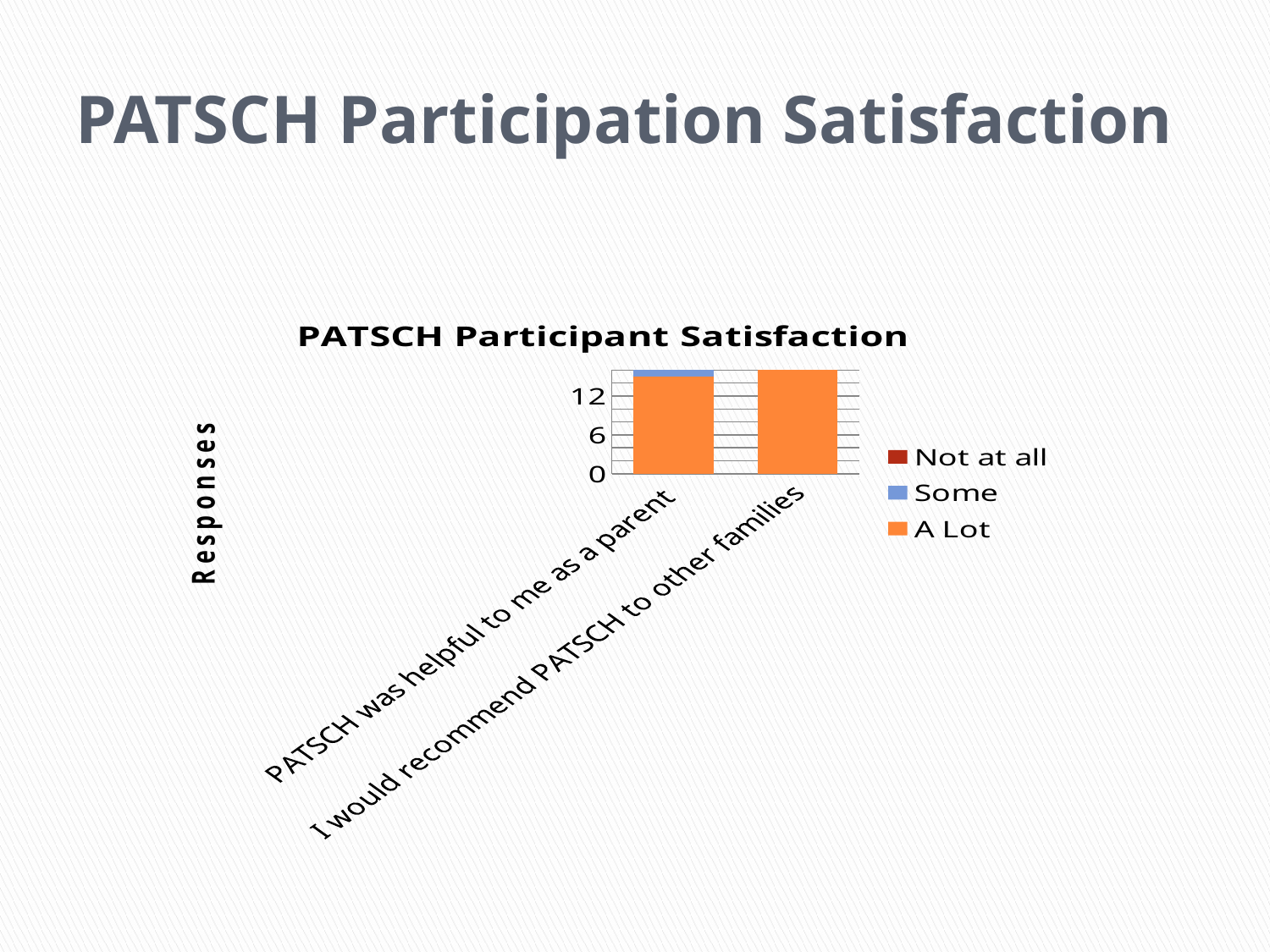
What is the title of the chart? PATSCH Participant Satisfaction Which category has the larger 'A Lot' value? I would recommend PATSCH to other families How many categories are shown on the x axis of the chart? 2 Is the 'Some' value for 'PATSCH was helpful to me as a parent' greater or less than 6? less Is the 'A Lot' value for 'PATSCH was helpful to me as a parent' greater or less than 12? greater What kind of chart is shown on the slide? bar chart Is the 'A Lot' value for 'I would recommend PATSCH to other families' greater or less than 12? greater Which category's bar includes a visible 'Some' segment? PATSCH was helpful to me as a parent How many series does the chart's legend list? 3